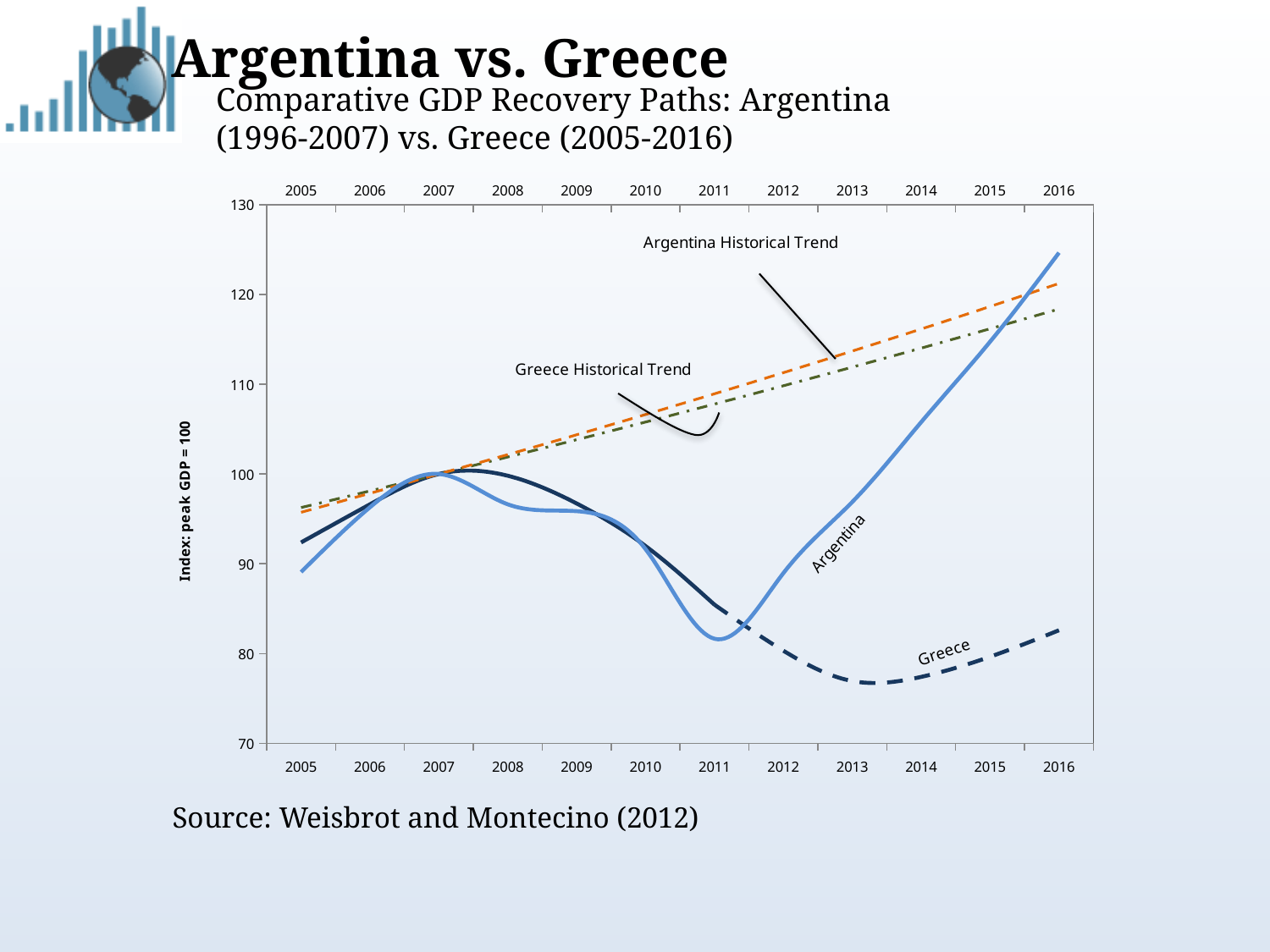
Is the value for Greece in 2013 greater or less than 80? less In 2013, which line is higher, Argentina or Greece? Argentina How many years are marked along the x axis of the chart? 12 Is the value for Argentina in 2016 greater or less than 120? greater Is the value for Greece in 2016 greater or less than 90? less Does the Argentina line rise or fall between 2011 and 2016? rise What kind of chart is shown on the slide? line chart Does the Greece line rise or fall between 2007 and 2013? fall What is the label on the y axis of the chart? Index: peak GDP = 100 In 2016, which line is higher, Argentina or Greece? Argentina